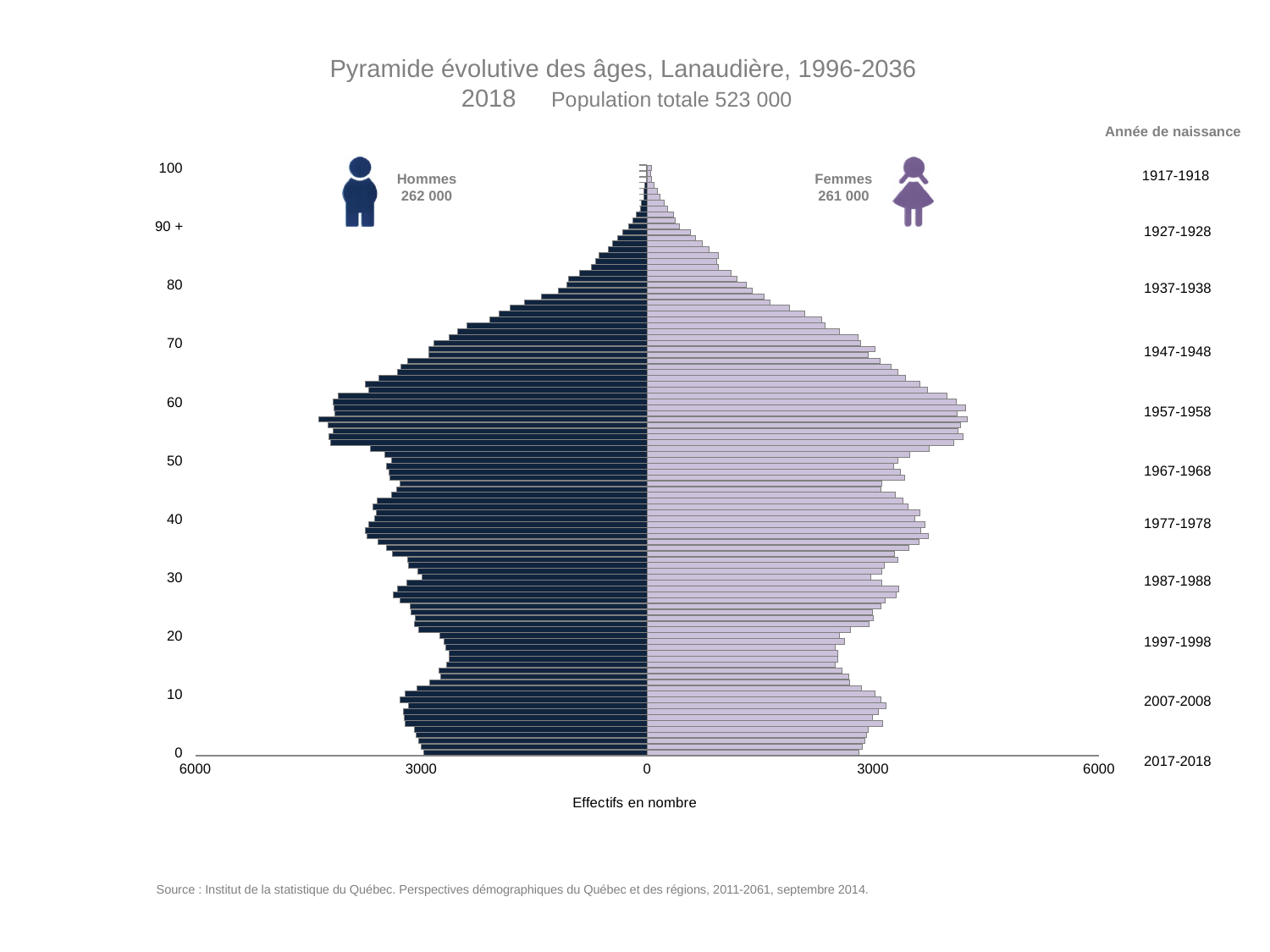
What is the difference between the number of Hommes and the number of Femmes? 1 000 Is the value for Hommes at age 58 greater or less than 3000? greater What is the total population shown for 2018? 523 000 What is the label of the horizontal axis? Effectifs en nombre What is the number of Hommes (men) shown on the chart? 262 000 What is the number of Femmes (women) shown on the chart? 261 000 Is the value for Femmes at age 40 greater or less than 3000? greater Is the value for Hommes at age 80 greater or less than 3000? less How many series (groups) does the chart show? 2 Which group is larger, Hommes or Femmes? Hommes What kind of chart is shown on the slide? Bar chart (population pyramid) Do the bars for Hommes get longer or shorter as age increases from 60 to 100? shorter